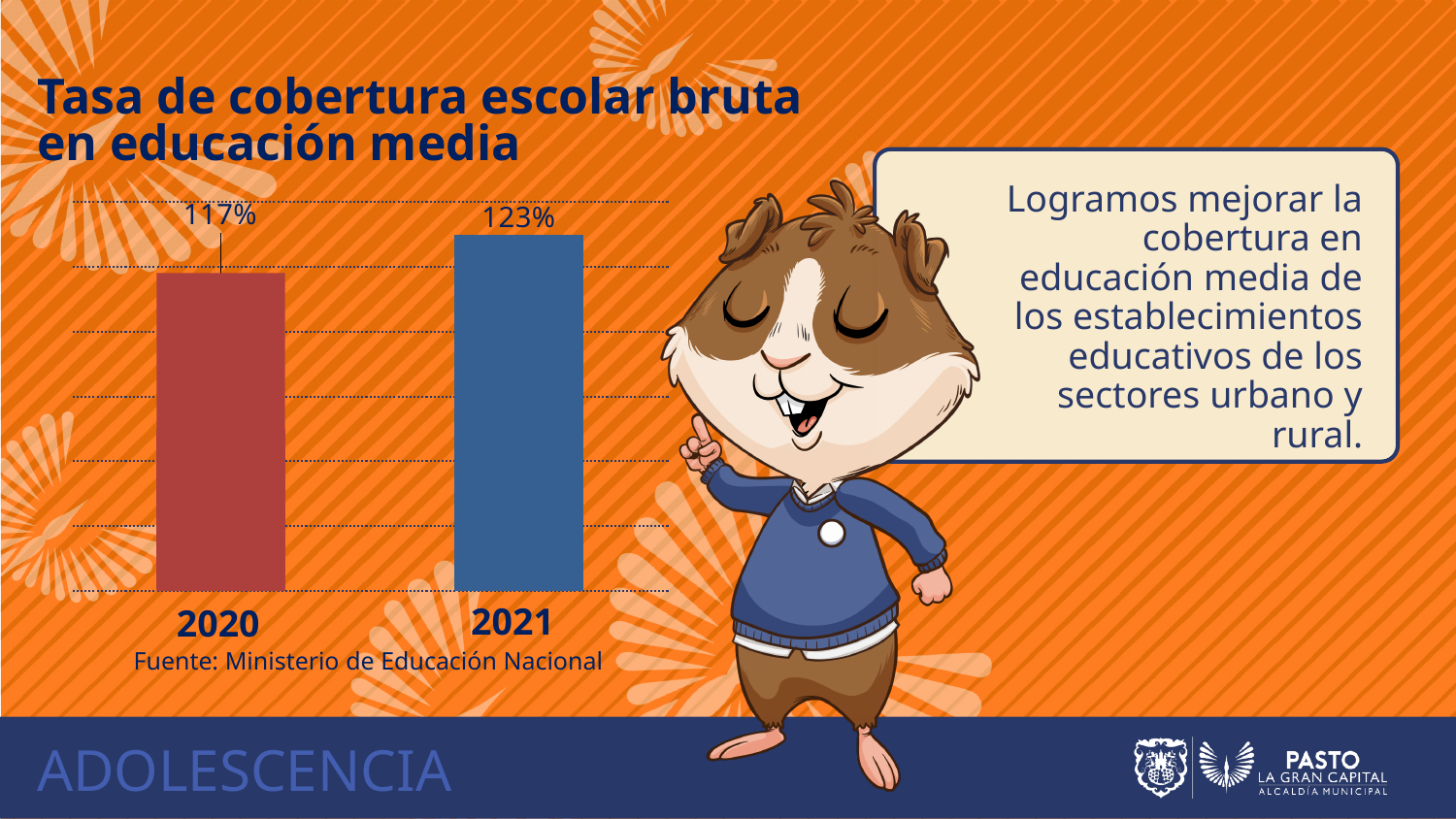
What is the title of the chart? Tasa de cobertura escolar bruta en educación media Which year has the lower coverage rate? 2020 Does the coverage rate rise or fall from 2020 to 2021? rise Is the value for 2021 larger or smaller than the value for 2020? larger By how many percentage points did the coverage rate change from 2020 to 2021? 6 percentage points What source is cited for the chart data? Ministerio de Educación Nacional Which year has the higher coverage rate? 2021 What kind of chart is shown on the slide? bar chart What is the gross school coverage rate in secondary education for 2021? 123% How many years are shown in the chart? 2 What is the gross school coverage rate in secondary education for 2020? 117%